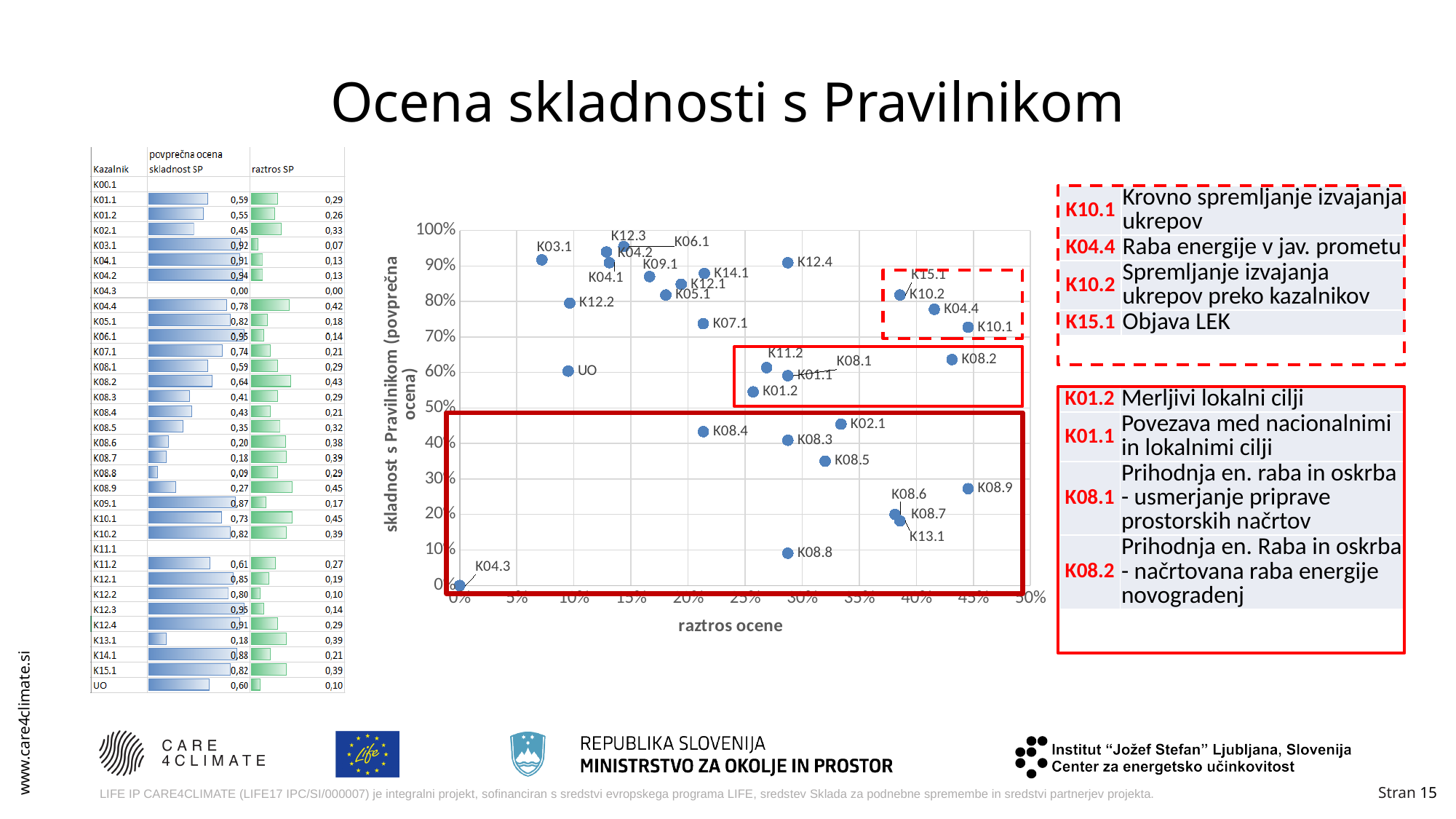
What kind of chart is shown on the slide? scatter chart Is the y-axis value (skladnost s Pravilnikom) for K08.5 greater or less than 40%? less Is the y-axis value (skladnost s Pravilnikom) for K10.1 greater or less than 80%? less Which point has the higher y-axis value (skladnost s Pravilnikom), K08.9 or K08.8? K08.9 Which point has the lowest value on the y axis (skladnost s Pravilnikom) in the scatter chart? K04.3 Is the x-axis value (raztros ocene) for K08.2 greater or less than 40%? greater Which point has the larger x-axis value (raztros ocene), K08.2 or K11.2? K08.2 What is the title of the x axis of the scatter chart? raztros ocene What is the y-axis value (skladnost s Pravilnikom) of point K04.3 in the scatter chart? 0% What is the title of the y axis of the scatter chart? skladnost s Pravilnikom (povprečna ocena)